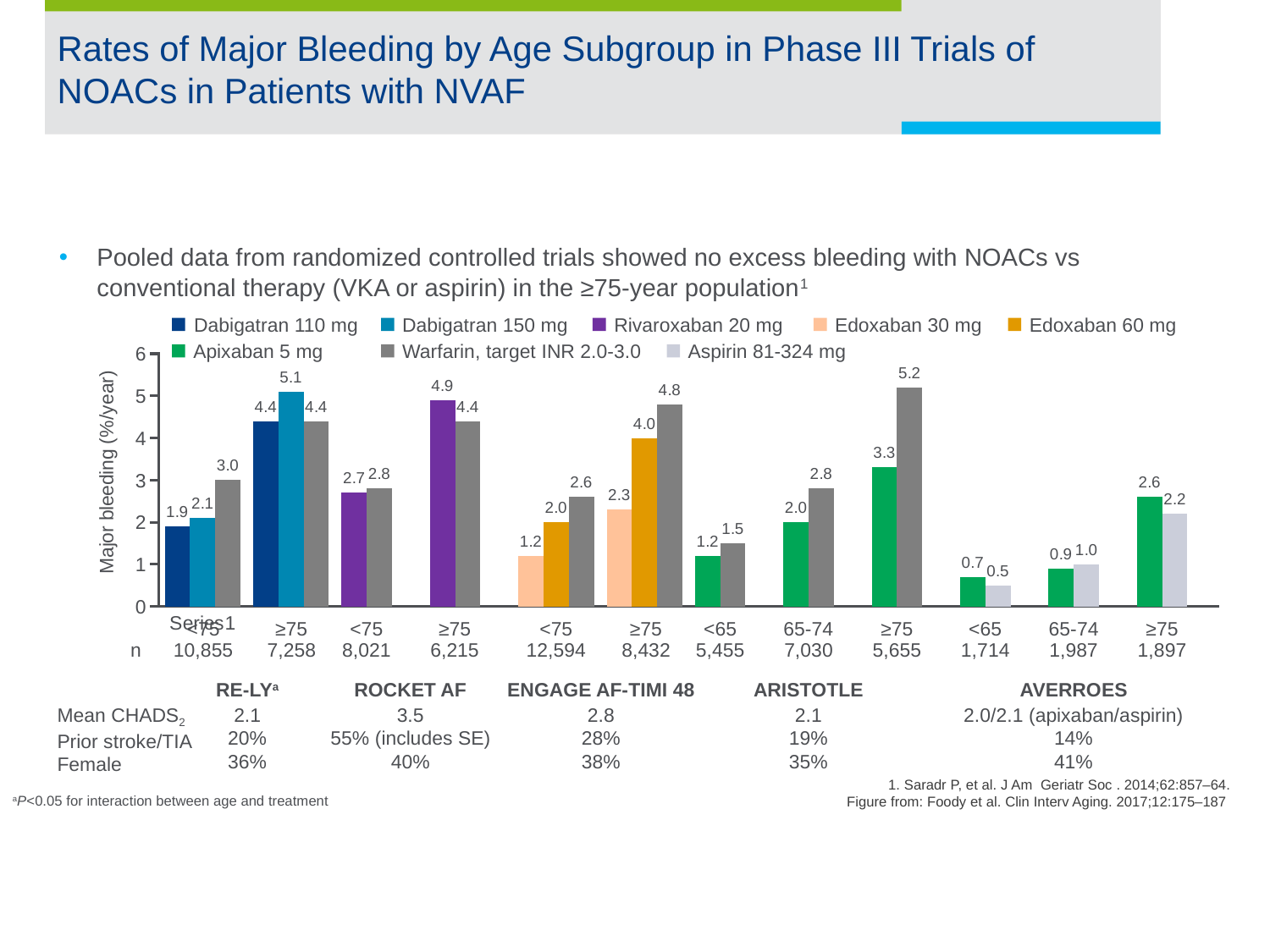
What type of chart is shown on the slide? Bar chart What is the difference between the warfarin and Apixaban 5 mg major bleeding rates in the ≥75 group of ARISTOTLE? 1.9 What is the major bleeding rate for Dabigatran 150 mg in the ≥75 age group of RE-LY? 5.1 What is the major bleeding rate for Rivaroxaban 20 mg in the ≥75 age group of ROCKET AF? 4.9 How many series does the chart legend list? 8 What is the n for the ≥75 age group in ROCKET AF? 6,215 What is the label of the y axis of the chart? Major bleeding (%/year) What is the major bleeding rate for Edoxaban 60 mg in the ≥75 age group of ENGAGE AF-TIMI 48? 4.0 Is the major bleeding rate for warfarin in the ≥75 group of ENGAGE AF-TIMI 48 greater or less than 4? greater Which bar in the chart has the highest major bleeding rate? Warfarin, ≥75 group in ARISTOTLE (5.2) In the ≥75 group of AVERROES, which has the higher major bleeding rate, Apixaban 5 mg or Aspirin 81-324 mg? Apixaban 5 mg Which bar in the chart has the lowest major bleeding rate? Aspirin 81-324 mg, <65 group in AVERROES (0.5)